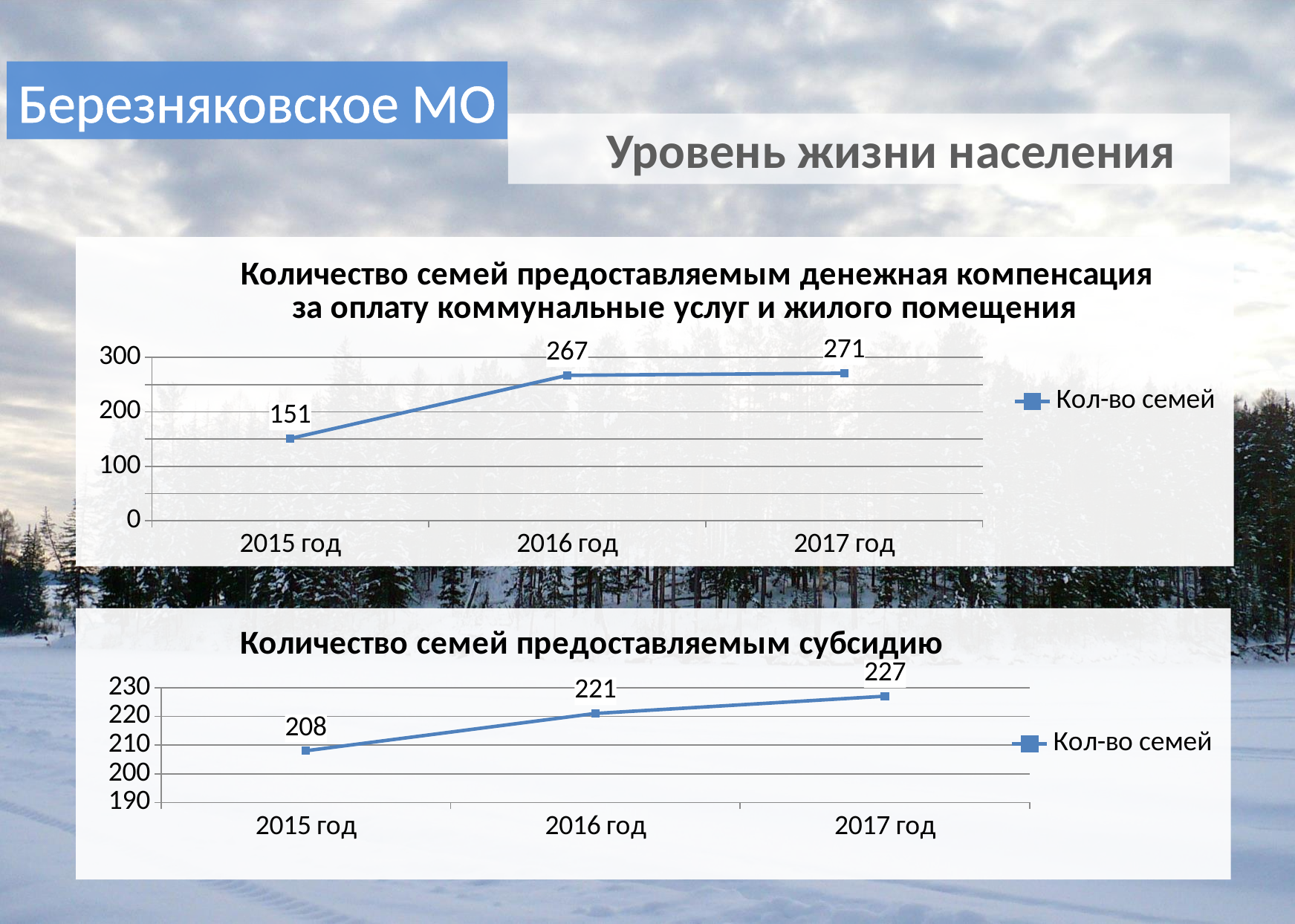
In the top chart, how many data points are plotted? 3 In the bottom chart, what series name does the legend show? Кол-во семей In the top chart, what is the value for 2015 год? 151 In the top chart, what kind of chart is shown? Line chart In the bottom chart (Количество семей предоставляемым субсидию), what is the value for 2017 год? 227 In the bottom chart, what is the value for 2015 год? 208 In the bottom chart, what is the difference between the values for 2017 год and 2016 год? 6 In the top chart, which year has the highest value? 2017 год In the bottom chart, which year has the lowest value? 2015 год In the bottom chart, do the values rise or fall from 2015 год to 2017 год? Rise In the top chart (Количество семей предоставляемым денежная компенсация за оплату коммунальные услуг и жилого помещения), what is the value for 2016 год? 267 In the top chart, what is the difference between the values for 2016 год and 2015 год? 116